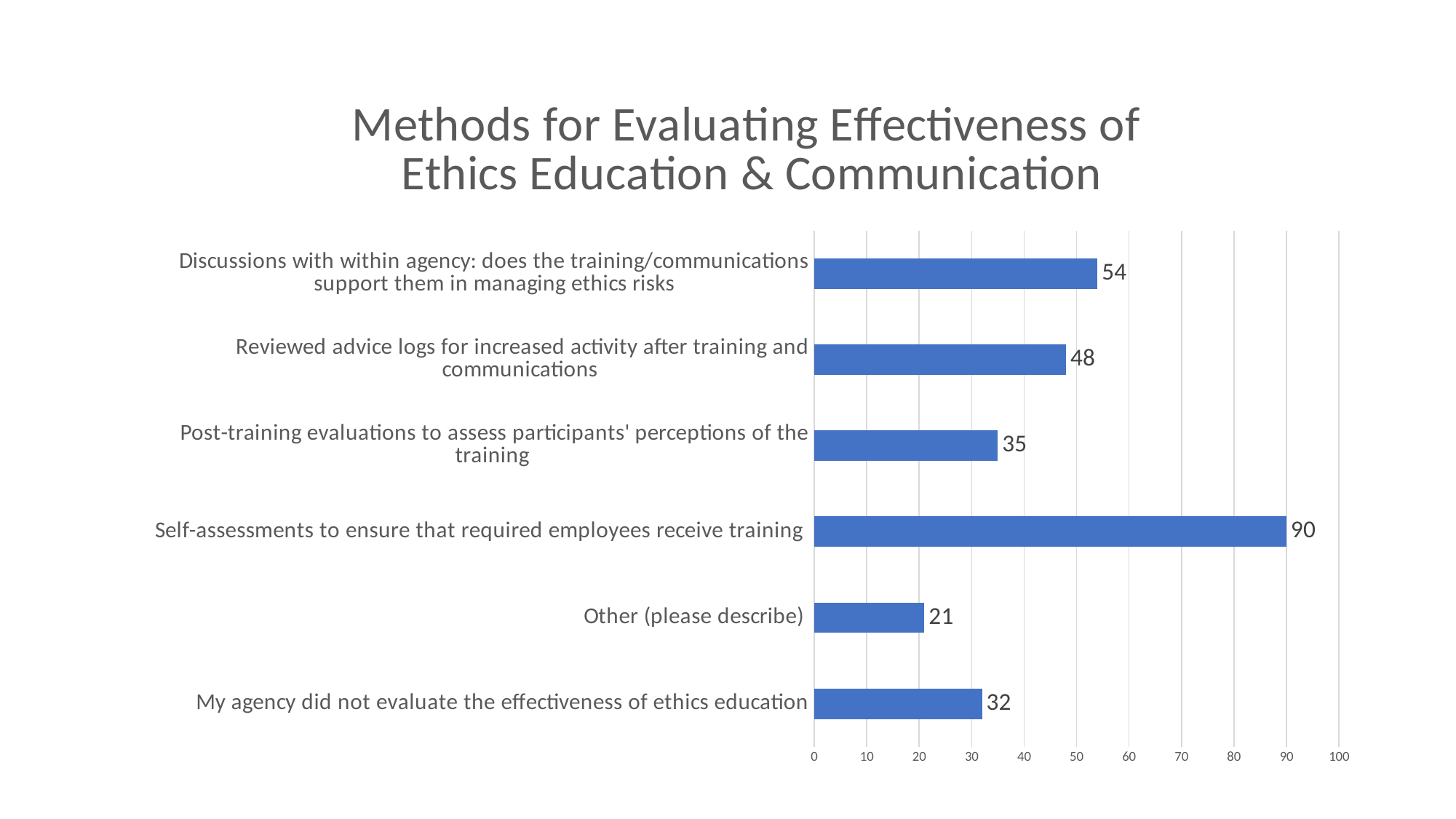
What is the value for "Other (please describe)"? 21 Which category has the lowest value? Other (please describe) Which category has the highest value? Self-assessments to ensure that required employees receive training How many categories are shown in the chart? 6 What is the difference between the values for "Discussions with within agency" and "Reviewed advice logs for increased activity after training and communications"? 6 What is the value for "Post-training evaluations to assess participants' perceptions of the training"? 35 Which is larger: the value for "Post-training evaluations" or the value for "My agency did not evaluate the effectiveness of ethics education"? Post-training evaluations What is the value for "Self-assessments to ensure that required employees receive training"? 90 What is the title of the chart? Methods for Evaluating Effectiveness of Ethics Education & Communication What kind of chart is shown on the slide? bar chart What is the value for "My agency did not evaluate the effectiveness of ethics education"? 32 Is the value for "Reviewed advice logs for increased activity after training and communications" greater or less than 40? greater